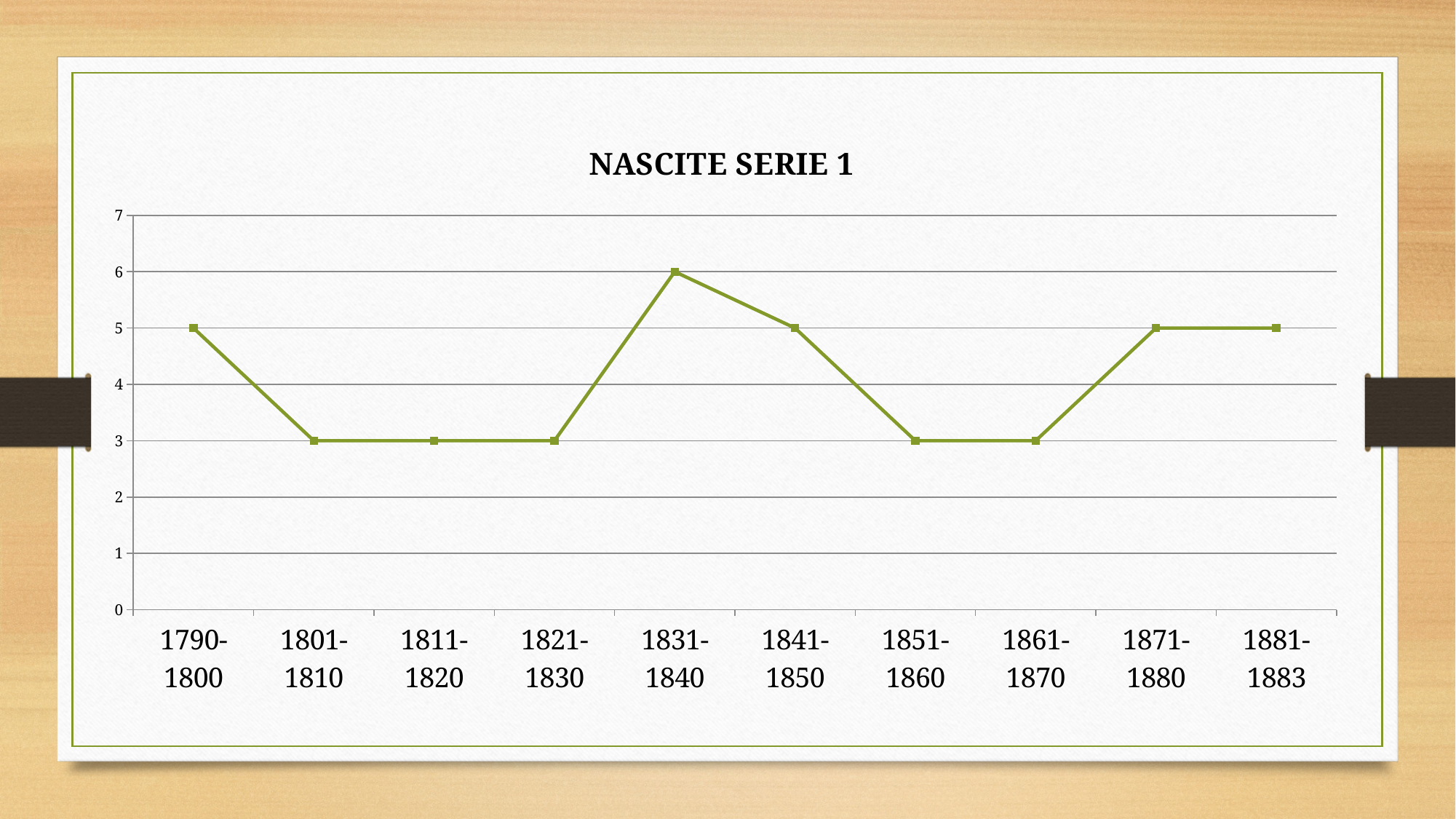
Is the value for 1871-1880 greater or less than 4? greater Which is larger, the value for 1841-1850 or the value for 1861-1870? 1841-1850 What is the value for 1831-1840? 6 What is the value for 1851-1860? 3 Which period has the highest value? 1831-1840 What kind of chart is shown on the slide? line chart What is the difference between the values for 1831-1840 and 1821-1830? 3 Does the value rise or fall from 1790-1800 to 1801-1810? fall What is the value for 1881-1883? 5 What is the value for 1790-1800? 5 How many periods are plotted along the x axis? 10 What is the title of the chart? NASCITE SERIE 1